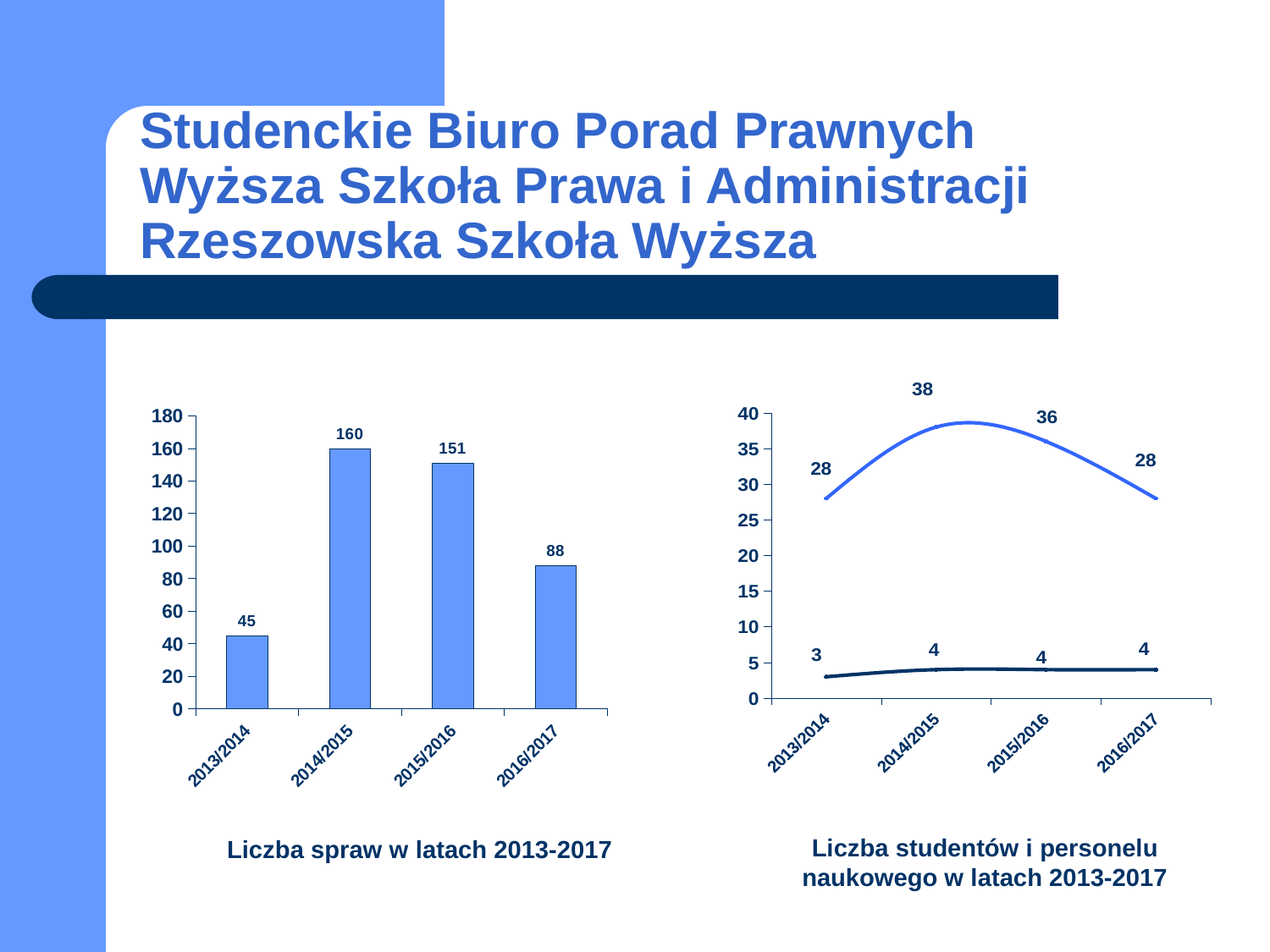
In the left chart (Liczba spraw w latach 2013-2017), how many years are shown on the x axis? 4 In the left chart (Liczba spraw w latach 2013-2017), which year has the lowest value? 2013/2014 In the left chart (Liczba spraw w latach 2013-2017), what is the difference between the values for 2014/2015 and 2013/2014? 115 In the right chart (Liczba studentów i personelu naukowego w latach 2013-2017), what is the value of the lower line for 2013/2014? 3 What kind of chart is the left chart (Liczba spraw w latach 2013-2017)? bar chart In the right chart (Liczba studentów i personelu naukowego w latach 2013-2017), what is the value of the upper line for 2014/2015? 38 In the left chart (Liczba spraw w latach 2013-2017), which year has the highest value? 2014/2015 What kind of chart is the right chart (Liczba studentów i personelu naukowego w latach 2013-2017)? line chart In the left chart (Liczba spraw w latach 2013-2017), what is the value for 2016/2017? 88 In the right chart (Liczba studentów i personelu naukowego w latach 2013-2017), what is the difference between the upper line's values for 2014/2015 and 2016/2017? 10 In the right chart (Liczba studentów i personelu naukowego w latach 2013-2017), which of the upper line's values is larger: 2014/2015 or 2016/2017? 2014/2015 In the left chart (Liczba spraw w latach 2013-2017), what is the value for 2014/2015? 160